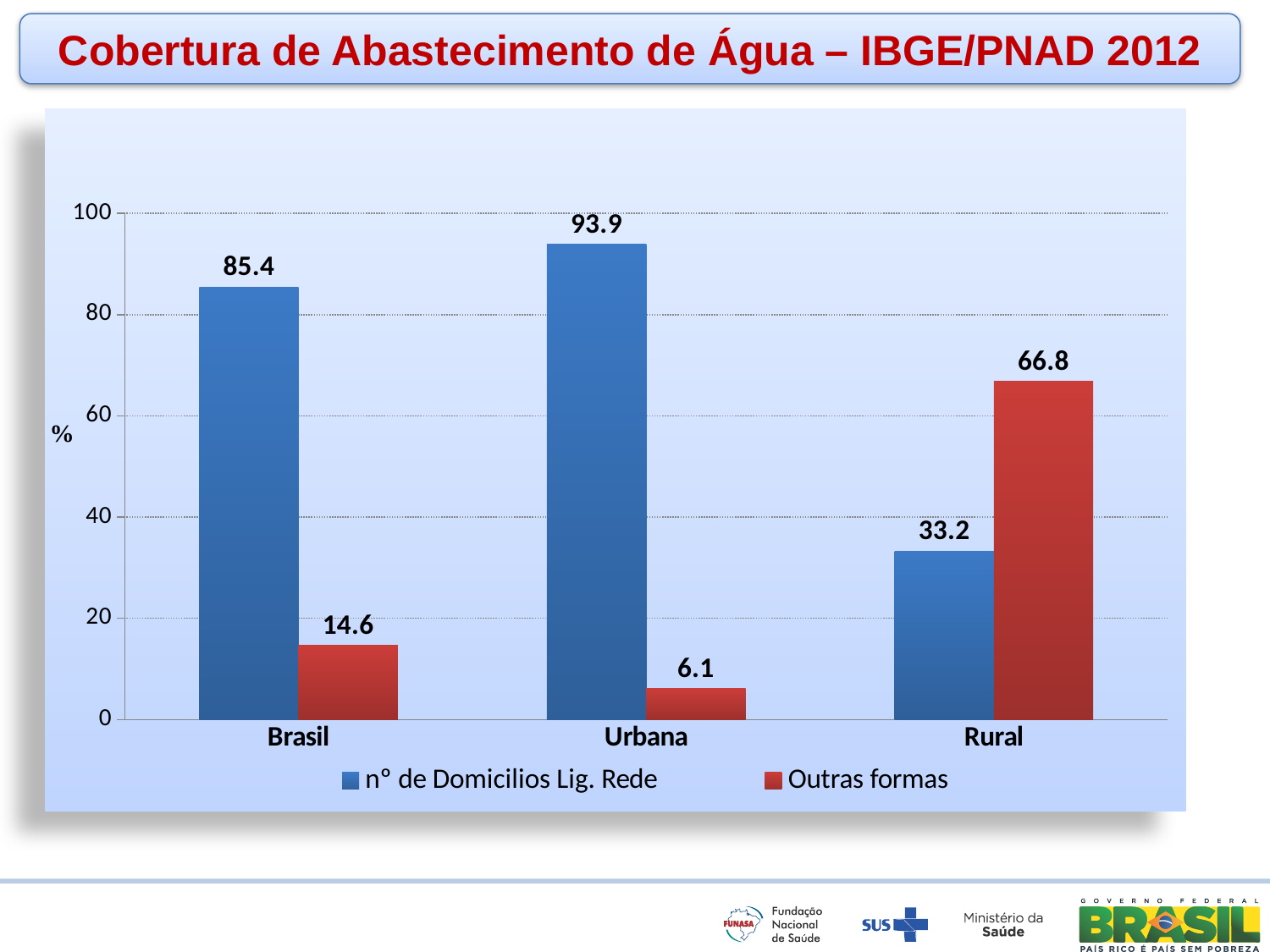
How many categories are shown on the x axis? 3 What kind of chart is shown on the slide? Bar chart What is the value for 'Outras formas' in the Urbana category? 6.1 What is the value for 'Outras formas' in the Rural category? 66.8 What is the difference between the 'n° de Domicilios Lig. Rede' values for Urbana and Rural? 60.7 Which category has the highest value for 'n° de Domicilios Lig. Rede'? Urbana What is the title of the slide containing the chart? Cobertura de Abastecimento de Água – IBGE/PNAD 2012 Which category has the lowest value for 'Outras formas'? Urbana Is the value for 'Outras formas' in Brasil greater or less than 20? less How many series does the legend list? 2 In the Rural category, which series has the larger value: 'n° de Domicilios Lig. Rede' or 'Outras formas'? Outras formas What is the value for 'n° de Domicilios Lig. Rede' in the Brasil category? 85.4